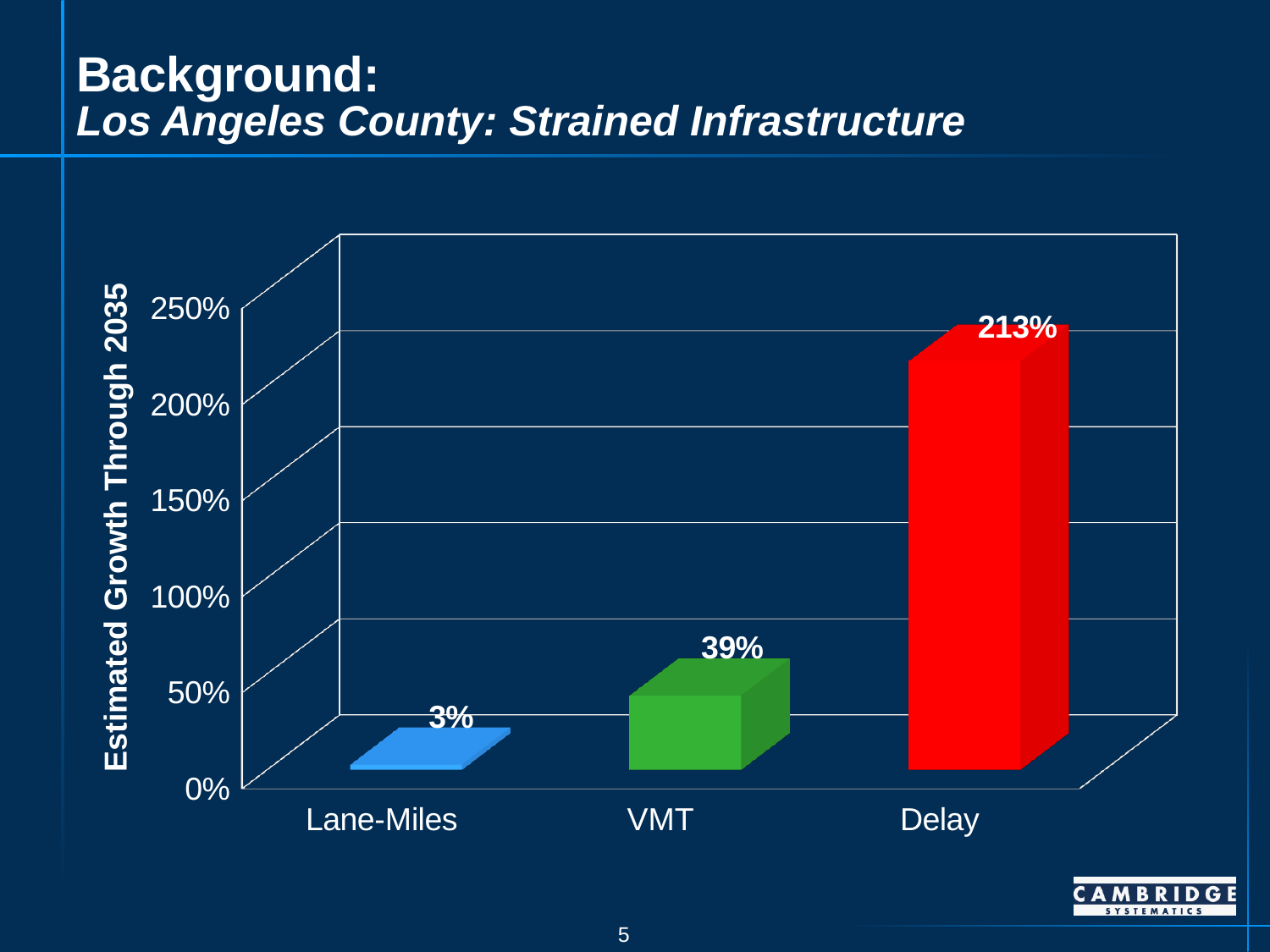
How many categories are shown on the x axis of the chart? 3 What is the difference in estimated growth between VMT and Lane-Miles? 36% What is the estimated growth through 2035 for VMT? 39% Is the estimated growth for Delay greater or less than 200%? greater What is the estimated growth through 2035 for Lane-Miles? 3% Which has a larger estimated growth through 2035, VMT or Lane-Miles? VMT What is the estimated growth through 2035 for Delay? 213% What kind of chart is shown on the slide? Bar chart What is the label of the vertical axis of the chart? Estimated Growth Through 2035 What is the difference in estimated growth between Delay and VMT? 174% Which category has the lowest estimated growth through 2035? Lane-Miles Which category has the highest estimated growth through 2035? Delay